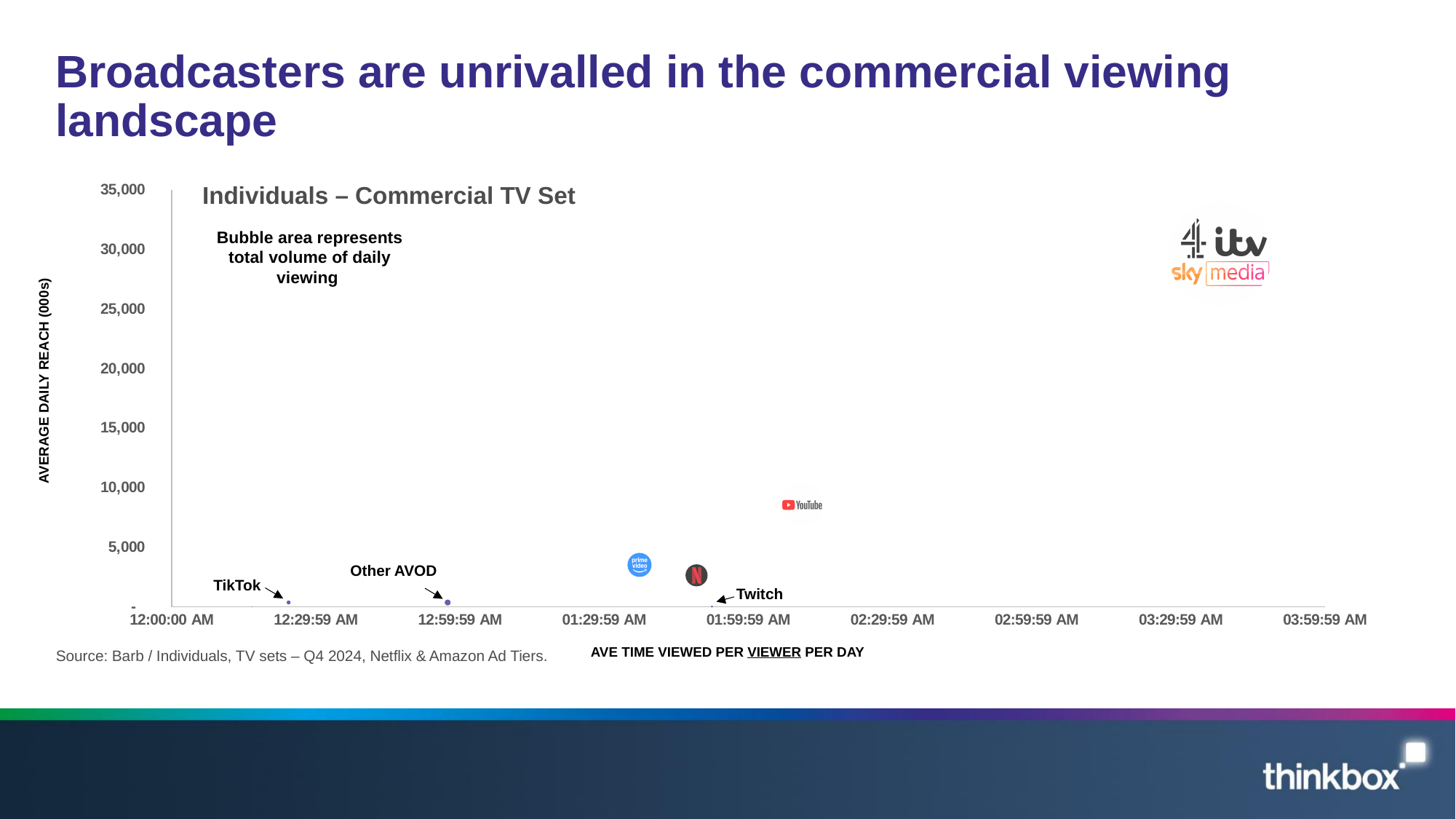
Which plotted service has the lowest average time viewed per viewer per day? TikTok Is the average daily reach for YouTube greater or less than 10,000? less Is the average daily reach for YouTube greater or less than 5,000? greater Which has the higher average daily reach, YouTube or Netflix? YouTube Is the average daily reach for TikTok greater or less than 5,000? less Which plotted group has the highest average daily reach? The broadcasters (Channel 4, ITV, Sky Media) Which has the longer average time viewed per viewer per day, YouTube or Prime Video? YouTube What kind of chart is shown on the slide? Bubble chart What is the title of the chart? Individuals – Commercial TV Set According to the note on the chart, what does the bubble area represent? Total volume of daily viewing